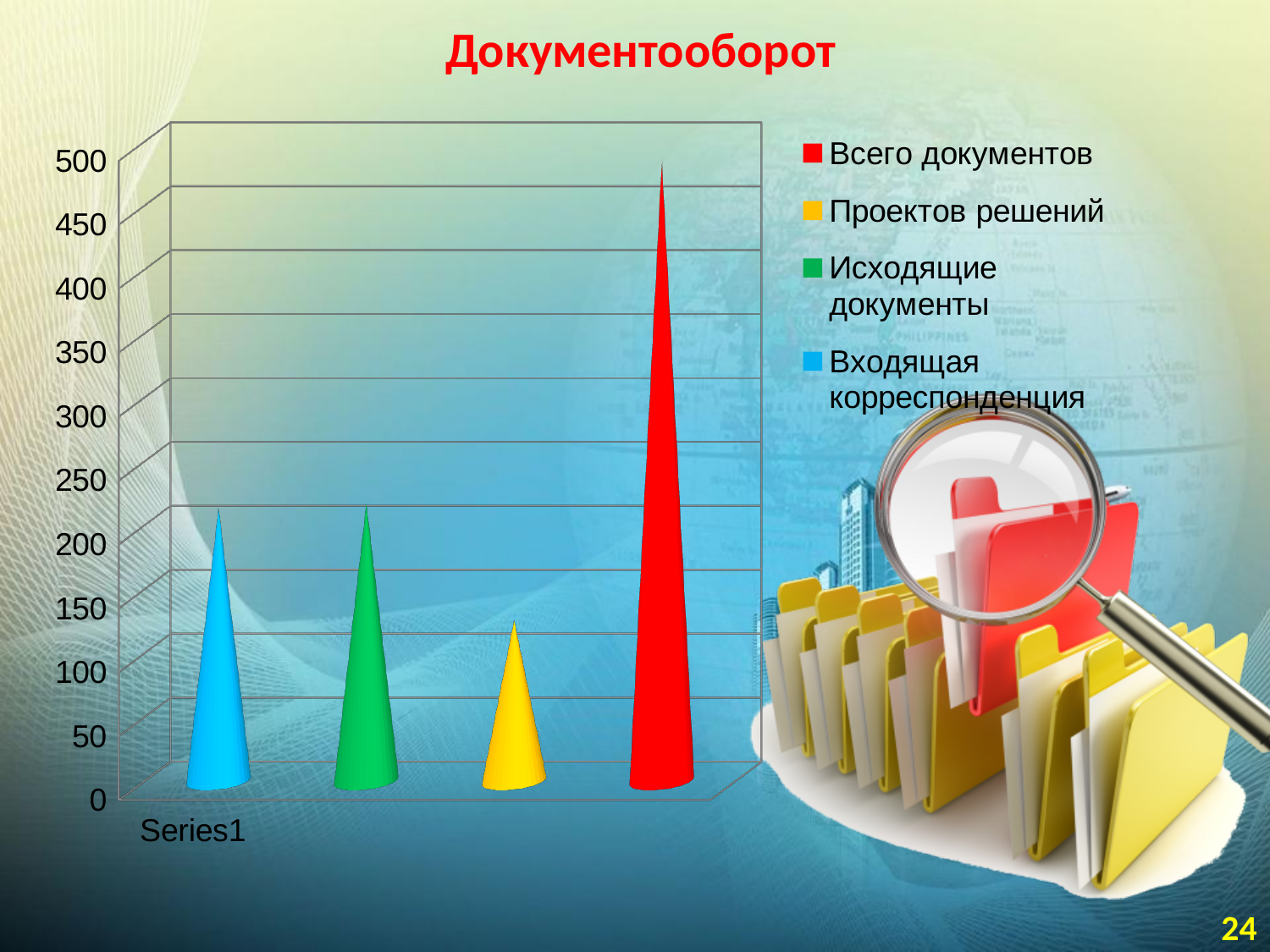
Which series has the lowest value? Проектов решений Is the value for Всего документов greater or less than 450? greater Which is larger, the value for Входящая корреспонденция or the value for Проектов решений? Входящая корреспонденция How many series does the legend list? 4 Which series has the highest value? Всего документов Is the value for Проектов решений greater or less than 150? less What kind of chart is shown on the slide? bar chart What is the title of the slide? Документооборот Is the value for Исходящие документы greater or less than 200? greater Which is larger, the value for Всего документов or the value for Проектов решений? Всего документов What colour represents Исходящие документы in the chart? green